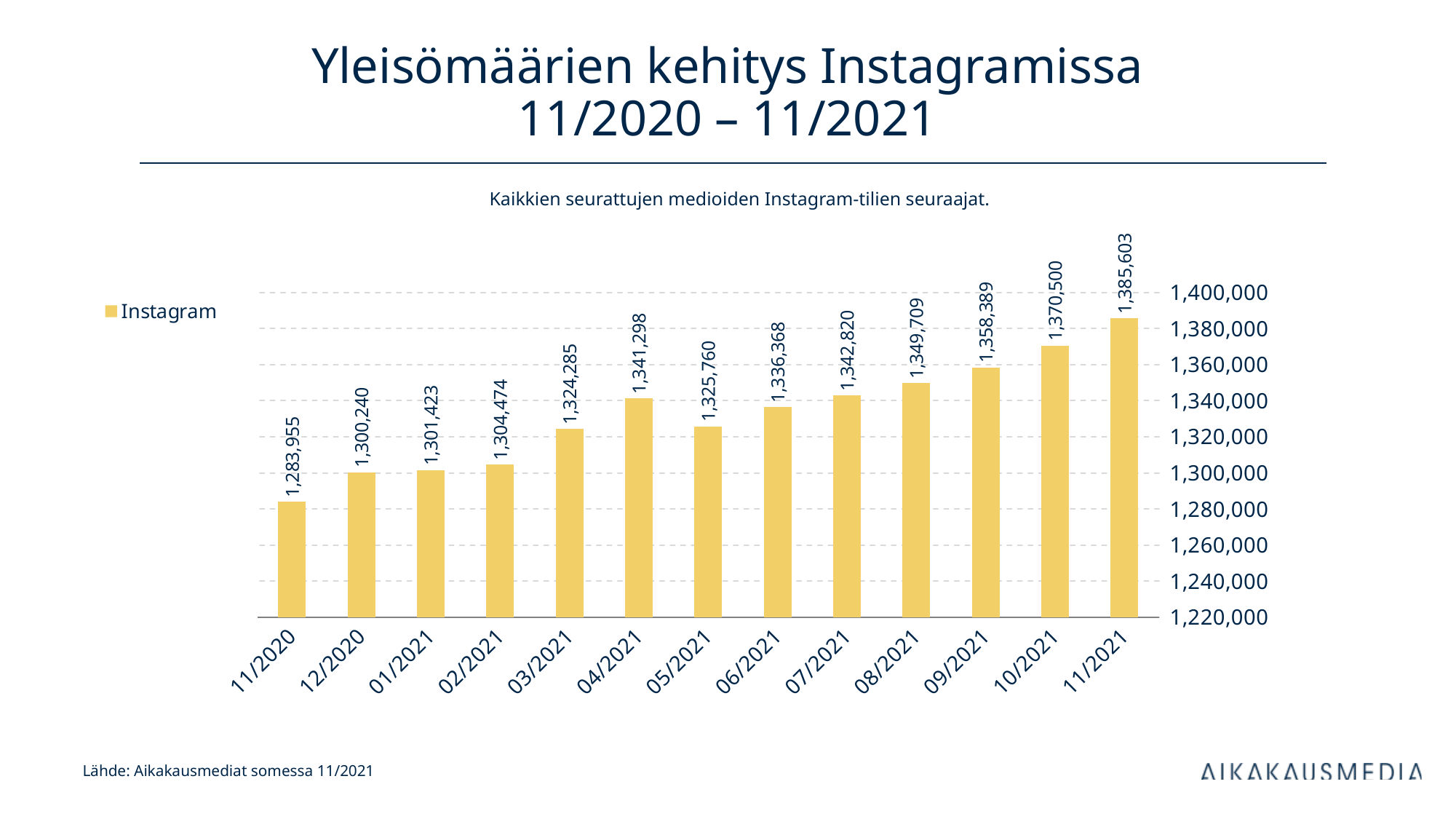
What kind of chart is shown on the slide? bar chart How many months are shown on the x axis? 13 What is the value for 04/2021? 1,341,298 What is the difference between the values for 11/2021 and 11/2020? 101,648 Is the value for 03/2021 greater or less than 1,320,000? greater What is the value for 11/2020? 1,283,955 What is the difference between the values for 10/2021 and 09/2021? 12,111 Which is larger, the value for 04/2021 or the value for 05/2021? 04/2021 Which month has the lowest value? 11/2020 What is the value for 11/2021? 1,385,603 What series name does the legend show? Instagram Which month has the highest value? 11/2021